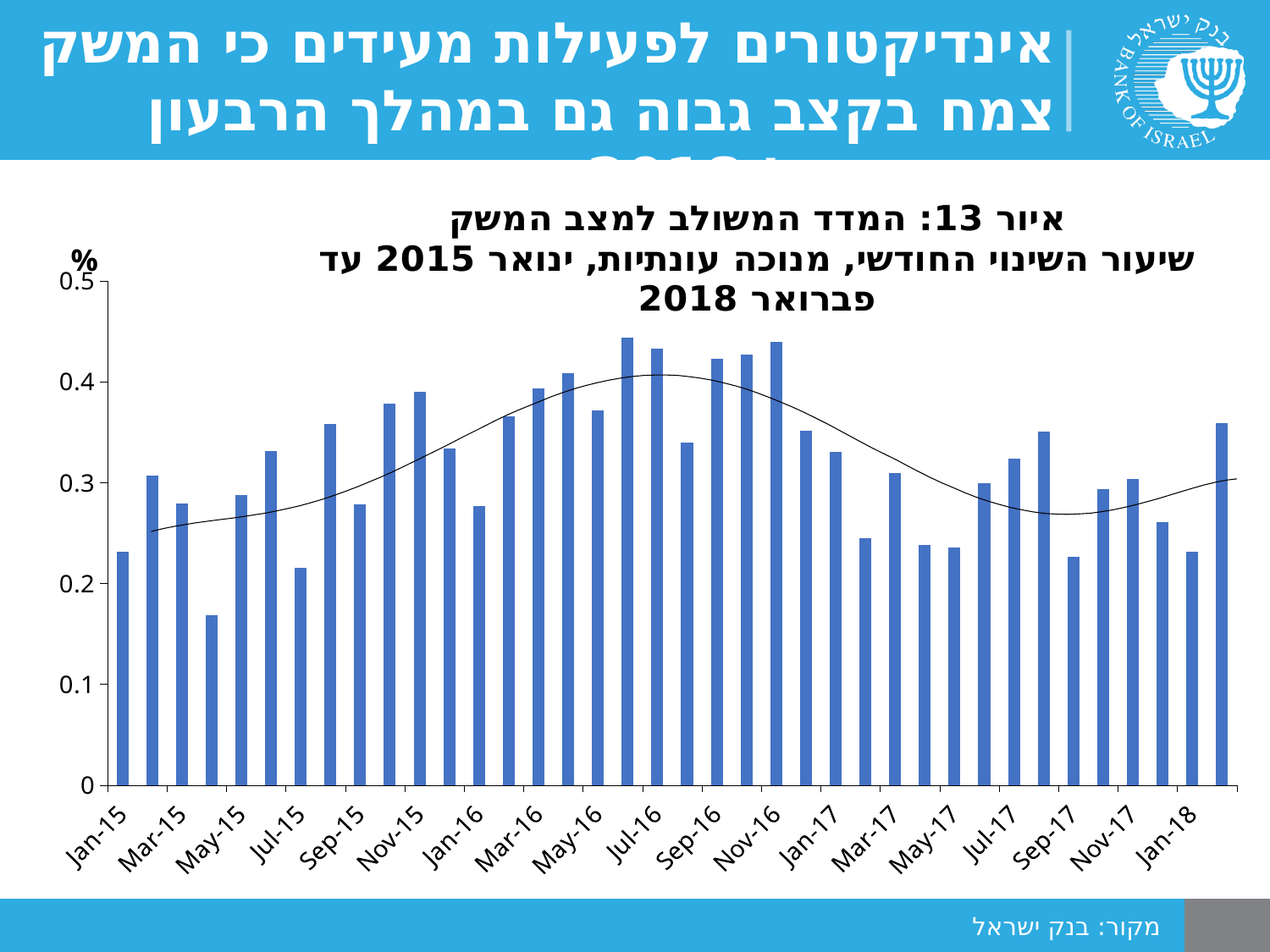
Is the value for Nov-15 greater or less than 0.3? greater Is the value for Jan-18 greater or less than 0.3? less Which is larger, the value for Jul-16 or the value for Jan-15? Jul-16 What is the figure number given in the chart title? 13 What kind of chart is shown on the slide? bar chart Do the values rise or fall from Jan-16 to Jul-16? rise Is the value for Jan-15 greater or less than 0.3? less What unit is shown at the top of the y axis? % Which is larger, the value for Sep-16 or the value for Sep-17? Sep-16 How many month labels are printed along the x axis? 19